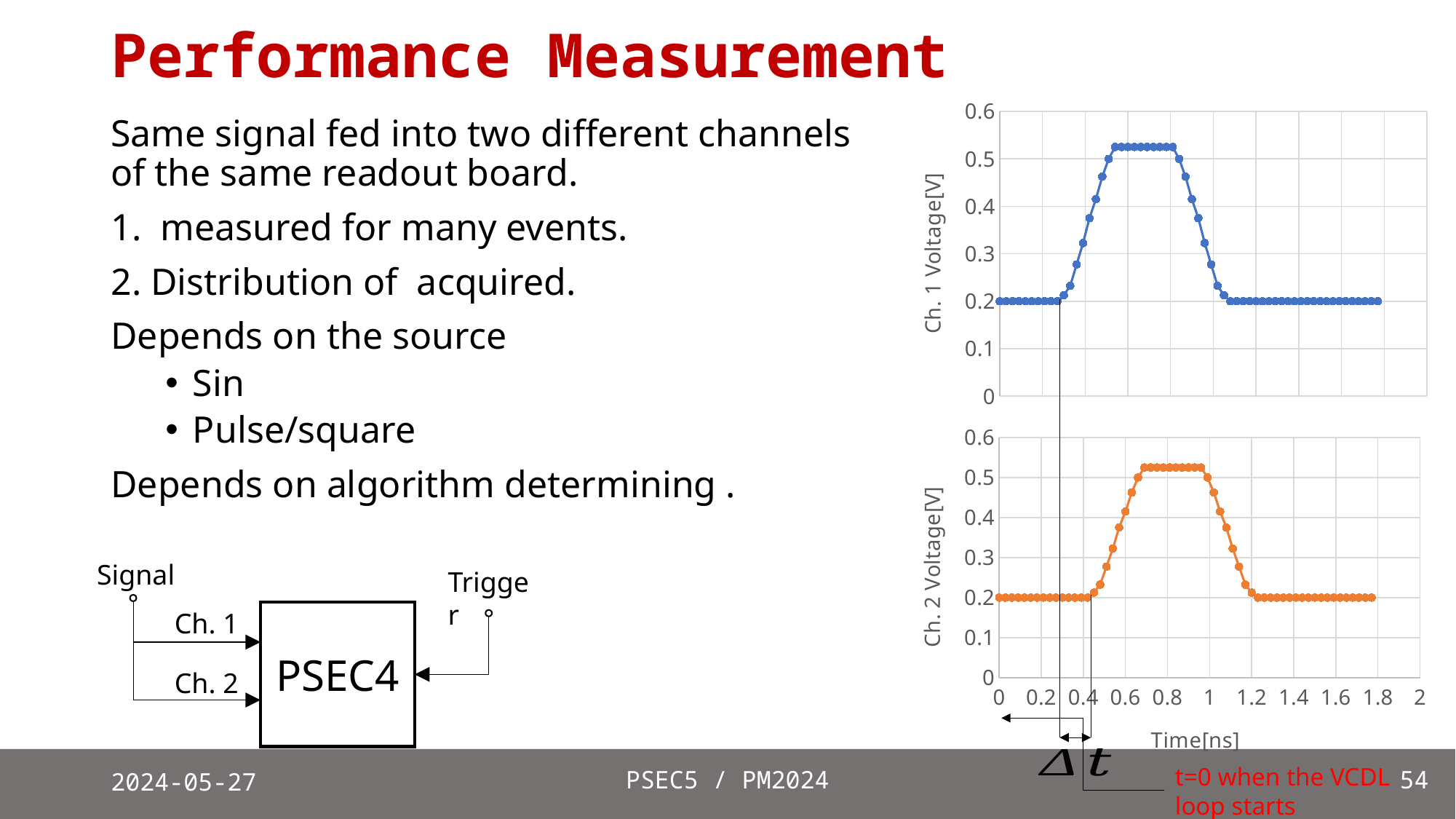
What is the y-axis label of the bottom chart? Ch. 2 Voltage[V] What kind of chart is the top chart (Ch. 1 Voltage[V])? scatter chart In the bottom chart (Ch. 2 Voltage[V]), does the voltage rise or fall between 1.0 ns and 1.2 ns? fall In the bottom chart (Ch. 2 Voltage[V]), is the voltage at time 1.6 ns greater or less than 0.3? less In the top chart (Ch. 1 Voltage[V]), does the voltage rise or fall between 0.3 ns and 0.5 ns? rise What is the x-axis label shared by the two charts on the right? Time[ns] What is the highest tick value shown on the y-axis of the top chart (Ch. 1 Voltage[V])? 0.6 In the top chart (Ch. 1 Voltage[V]), is the voltage at time 0 greater or less than 0.3? less In the top chart (Ch. 1 Voltage[V]), is the voltage at time 0.7 ns greater or less than 0.4? greater Which channel's pulse begins rising earlier in time, Ch. 1 (top chart) or Ch. 2 (bottom chart)? Ch. 1